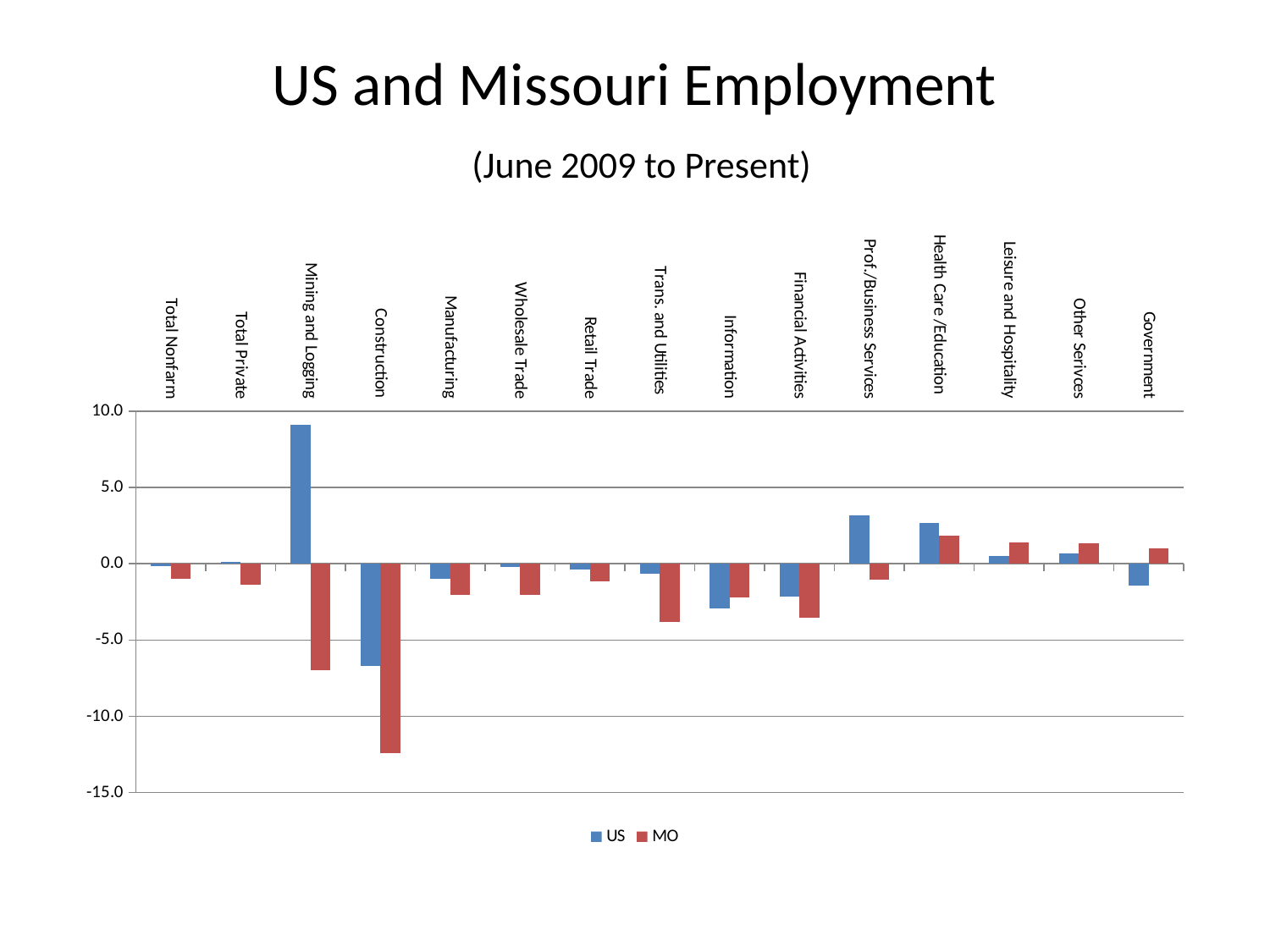
Is the US value for Mining and Logging greater or less than 5.0? greater How many series does the legend list? 2 Is the MO value for Mining and Logging greater or less than -5.0? less How many categories are plotted along the x axis? 15 For Mining and Logging, which series has the larger value, US or MO? US Is the MO value for Construction greater or less than -10.0? less What kind of chart is shown on the slide? Bar chart Which category has the lowest US value? Construction Which category has the lowest MO value? Construction For Government, which series has the larger value, US or MO? MO Which category has the highest US value? Mining and Logging What colour represents the MO series in the legend? Red